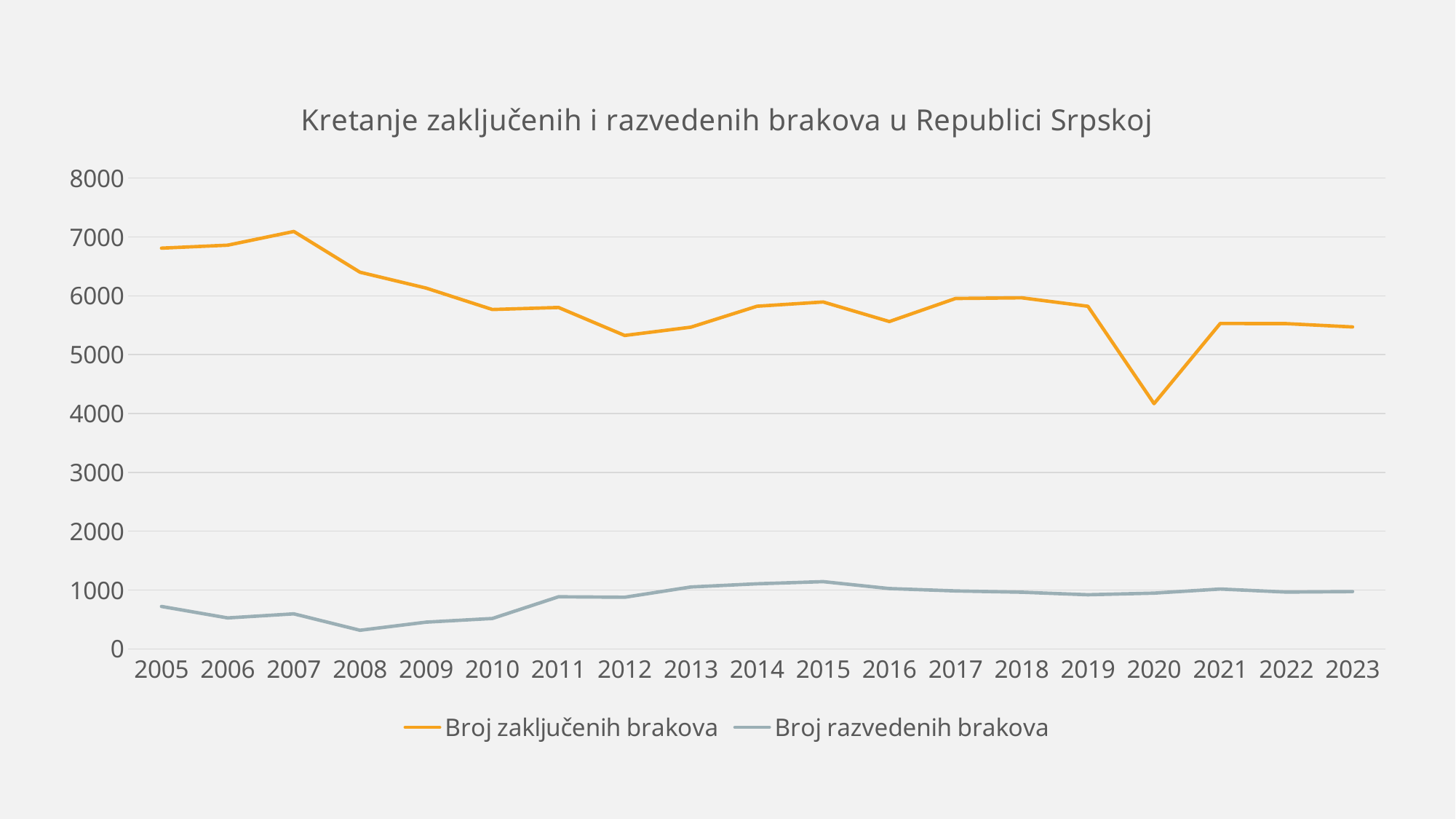
Does the value for Broj zaključenih brakova overall rise or fall from 2005 to 2023? fall What kind of chart is shown on the slide? line chart How many series does the legend list? 2 Which is larger for Broj zaključenih brakova: the value in 2007 or the value in 2008? 2007 Is the value for Broj zaključenih brakova in 2008 greater or less than 6000? greater In which year is the value for Broj zaključenih brakova lowest? 2020 How many years are plotted along the x axis? 19 In which year is the value for Broj zaključenih brakova highest? 2007 In which year is the value for Broj razvedenih brakova lowest? 2008 What is the title of the chart? Kretanje zaključenih i razvedenih brakova u Republici Srpskoj Is the value for Broj zaključenih brakova in 2020 greater or less than 5000? less Is the value for Broj razvedenih brakova in 2008 greater or less than 500? less